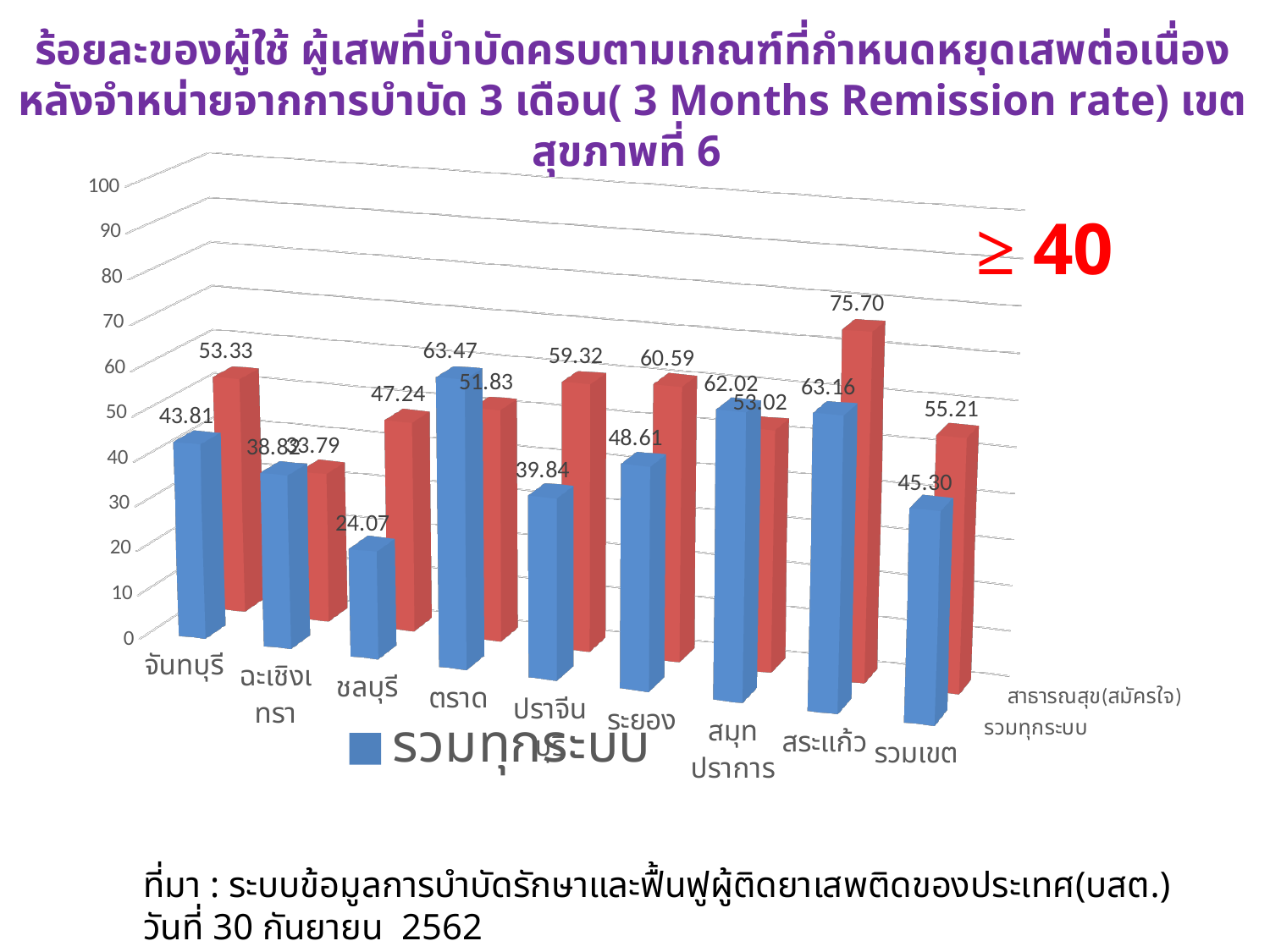
What is the value of รวมทุกระบบ for จันทบุรี? 43.81 How many categories are shown on the x axis? 9 What kind of chart is shown on the slide? bar chart What is the difference between the สาธารณสุข(สมัครใจ) and รวมทุกระบบ values for ชลบุรี? 23.17 What is the value of สาธารณสุข(สมัครใจ) for สระแก้ว? 75.70 What is the value of สาธารณสุข(สมัครใจ) for รวมเขต? 55.21 Which category has the lowest value for รวมทุกระบบ? ชลบุรี What is the value of รวมทุกระบบ for ชลบุรี? 24.07 For ตราด, which is larger: รวมทุกระบบ or สาธารณสุข(สมัครใจ)? รวมทุกระบบ Is the รวมทุกระบบ value for ปราจีนบุรี greater or less than 40? less Which province has the highest value for สาธารณสุข(สมัครใจ)? สระแก้ว What is the difference between the สาธารณสุข(สมัครใจ) and รวมทุกระบบ values for สระแก้ว? 12.54